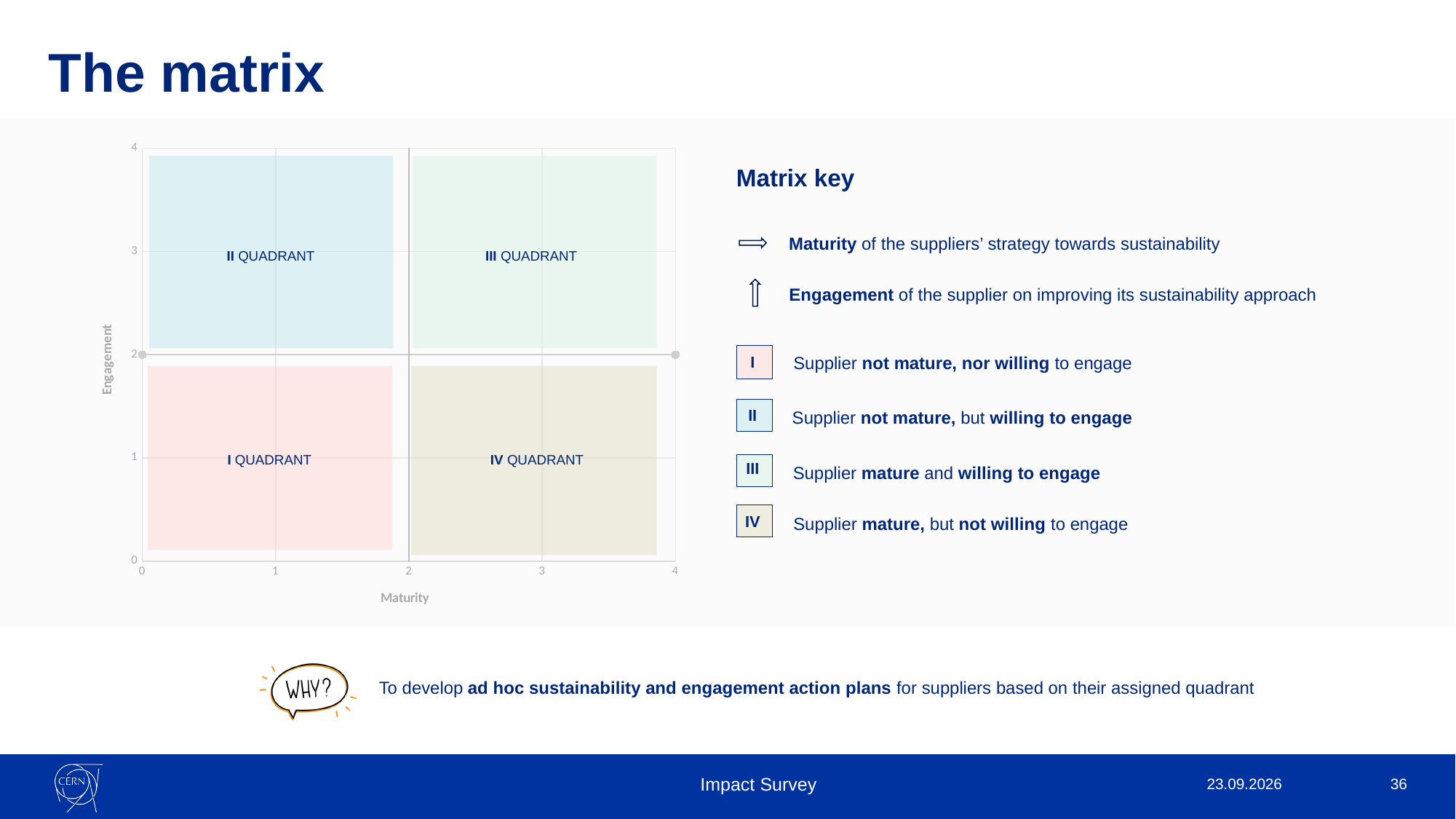
At what Maturity value is the vertical dividing line between the left and right quadrants drawn? 2 What is the maximum value shown on the Maturity axis of the matrix chart? 4 What is the maximum value shown on the Engagement axis of the matrix chart? 4 What is the label of the horizontal axis of the matrix chart? Maturity At what Engagement value is the horizontal dividing line between the upper and lower quadrants drawn? 2 What is the label of the vertical axis of the matrix chart? Engagement How many quadrants are shown in the matrix chart? 4